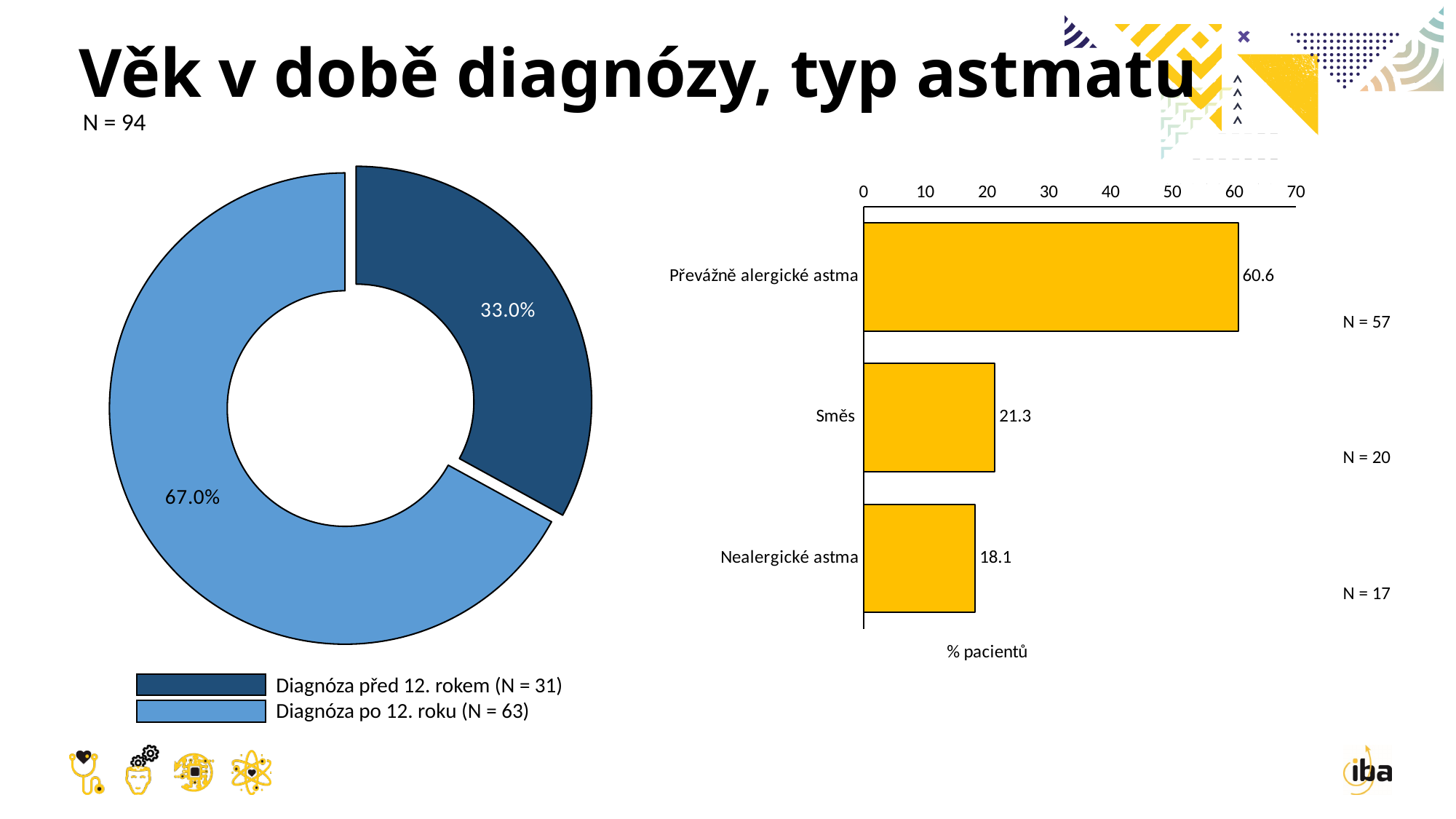
In the donut chart on the left, how many patients does the legend give for 'Diagnóza před 12. rokem'? N = 31 In the bar chart on the right, what is the value for 'Směs'? 21.3 In the bar chart on the right, what is the difference between the values for 'Převážně alergické astma' and 'Směs'? 39.3 In the bar chart on the right, what is the value for 'Převážně alergické astma'? 60.6 What kind of chart is shown on the right side of the slide? bar chart In the donut chart on the left, what share of patients were diagnosed after age 12 (Diagnóza po 12. roku)? 67.0% In the donut chart on the left, how many entries does the legend list? 2 In the bar chart on the right, what is the value for 'Nealergické astma'? 18.1 In the bar chart on the right, which category has the highest value? Převážně alergické astma In the donut chart on the left, what share of patients were diagnosed before age 12 (Diagnóza před 12. rokem)? 33.0% In the bar chart on the right, which category has the lowest value? Nealergické astma In the bar chart on the right, how many categories are plotted? 3